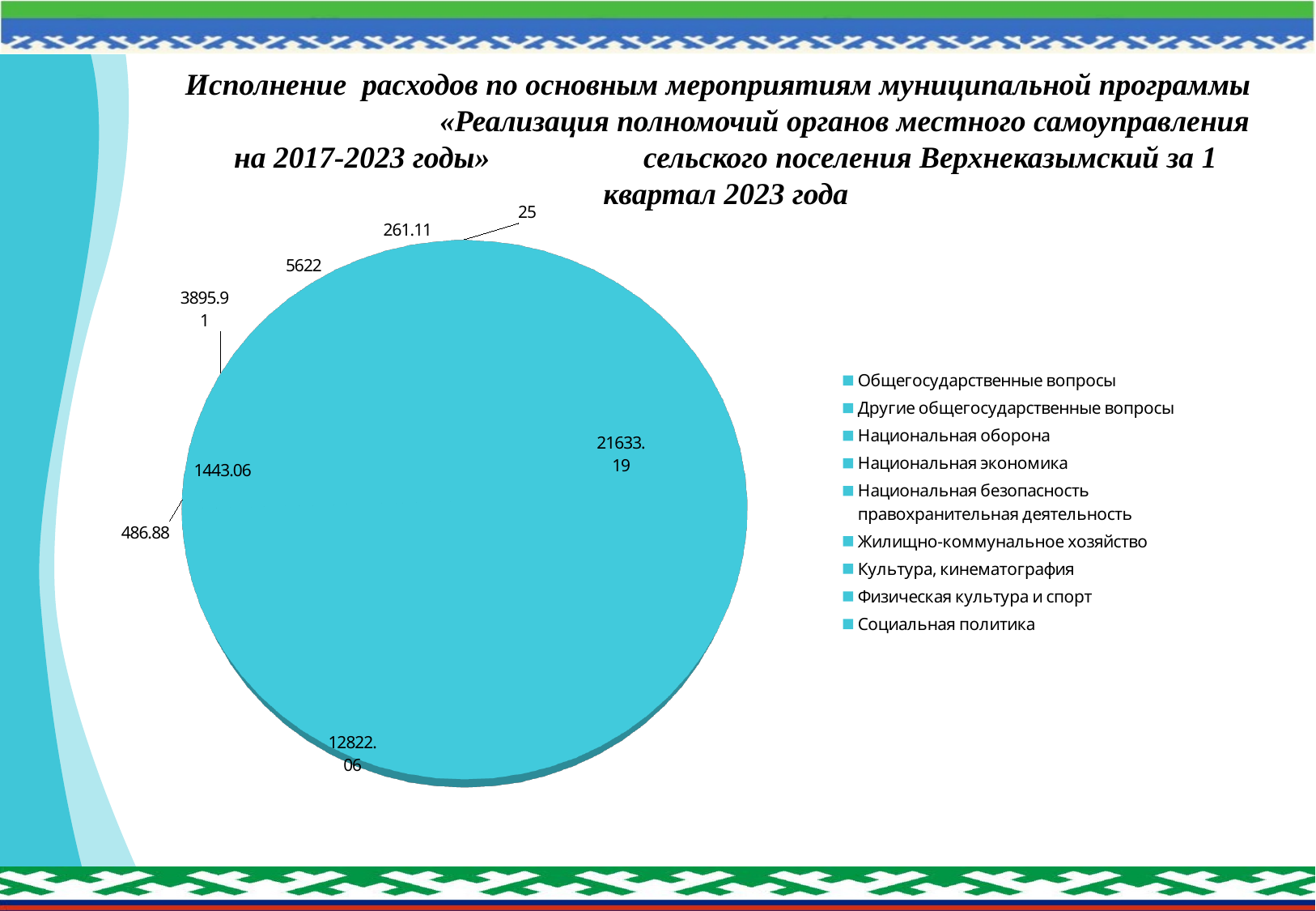
What is the last entry listed in the legend of the pie chart? Социальная политика What kind of chart is shown on the slide? pie chart Which labelled value on the pie chart is larger, 1443.06 or 486.88? 1443.06 How many entries does the legend of the pie chart list? 9 What is the difference between the labelled values 261.11 and 25 on the pie chart? 236.11 What is the first entry listed in the legend of the pie chart? Общегосударственные вопросы What is the difference between the two largest labelled values on the pie chart, 21633.19 and 12822.06? 8811.13 How many data labels are printed around the pie chart? 8 What is the smallest value labelled on the pie chart? 25 What is the largest value labelled on the pie chart? 21633.19 Which labelled value on the pie chart is larger, 5622 or 3895.91? 5622